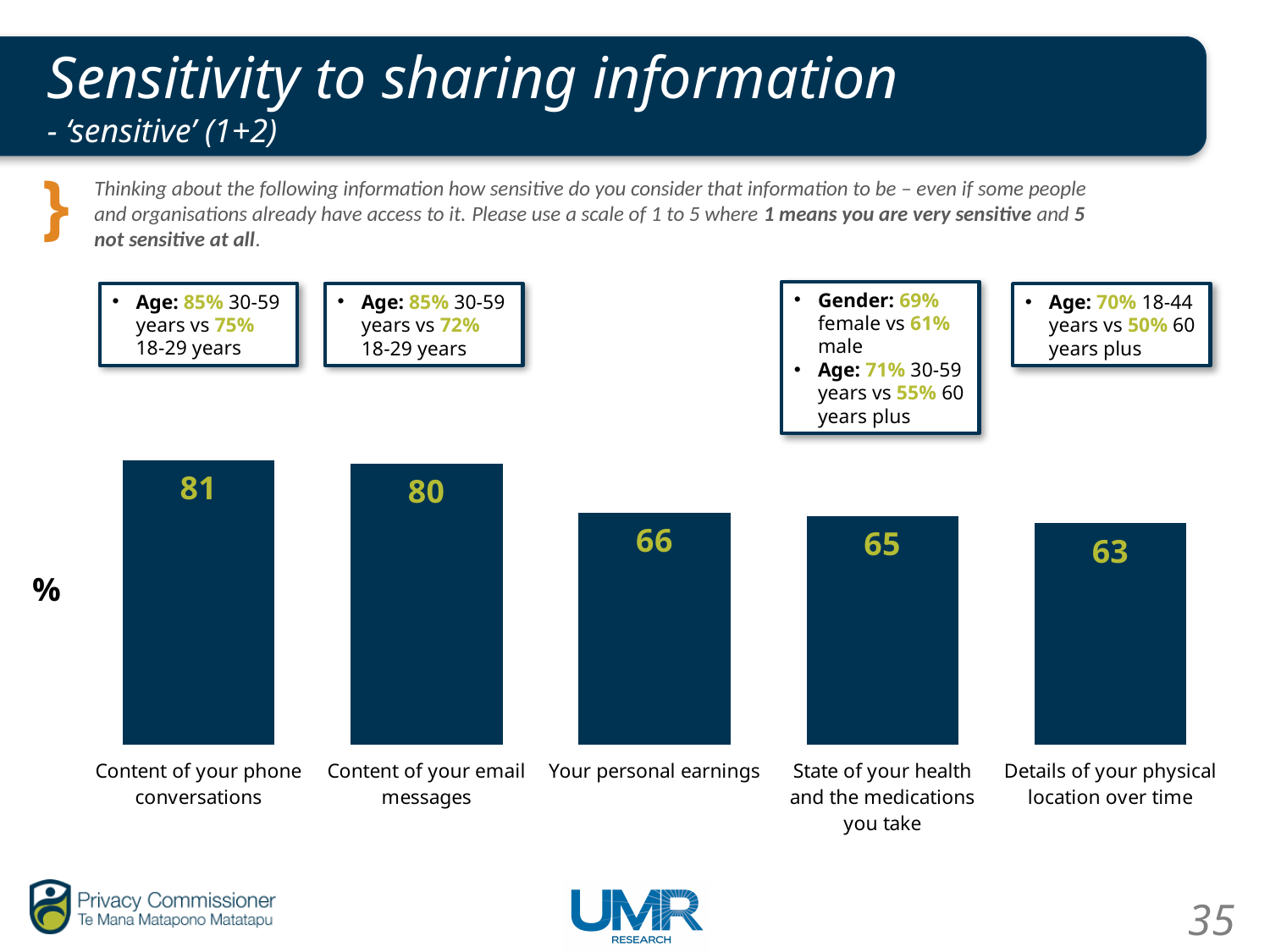
What kind of chart is shown on the slide? Bar chart How many categories are shown in the chart? 5 What is the value for 'Your personal earnings'? 66 Which is larger: the value for 'Content of your email messages' or the value for 'State of your health and the medications you take'? Content of your email messages What is the difference between the values for 'Content of your email messages' and 'Your personal earnings'? 14 Which category has the highest value? Content of your phone conversations What is the value for 'Details of your physical location over time'? 63 What is the value for 'State of your health and the medications you take'? 65 Which category has the lowest value? Details of your physical location over time What is the difference between the values for 'Content of your phone conversations' and 'Details of your physical location over time'? 18 Do the values rise or fall from left to right across the categories? Fall What is the value for 'Content of your phone conversations'? 81